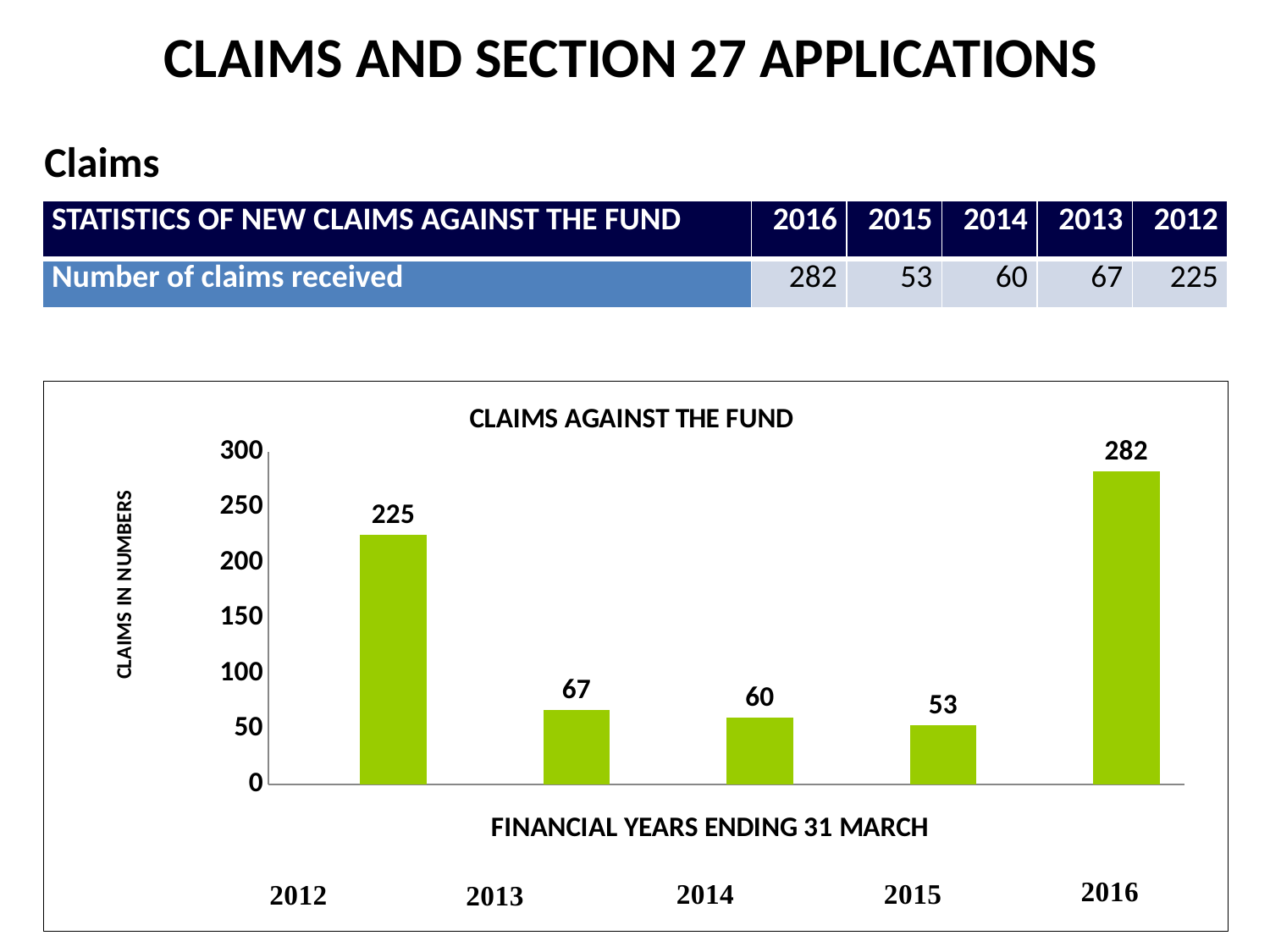
Is the value for 2016 greater or less than 250? greater Which year has the lowest number of claims in the chart? 2015 How many years are shown in the chart? 5 What is the title of the chart? CLAIMS AGAINST THE FUND What is the value for 2015 in the chart? 53 What is the difference between the values for 2016 and 2012? 57 What is the value for 2014 in the chart? 60 What is the difference between the values for 2013 and 2015? 14 What kind of chart is shown on the slide? bar chart What is the value for 2012 in the chart? 225 Which is larger, the value for 2013 or the value for 2014? 2013 Which year has the highest number of claims in the chart? 2016